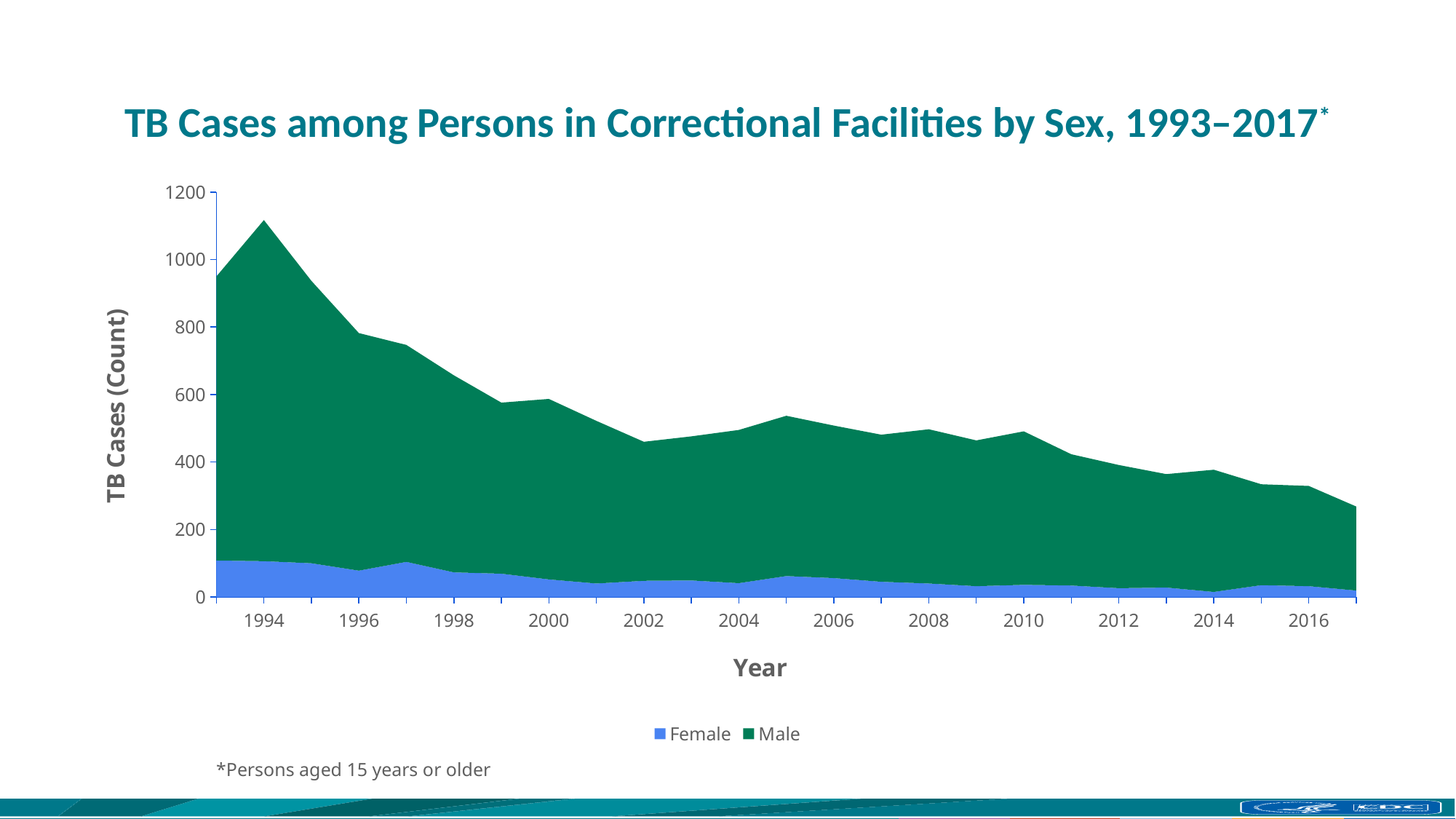
Overall, do total TB cases rise or fall from 1993 to 2017? Fall Which series are listed in the legend? Female and Male What kind of chart is shown on the slide? Stacked area chart Is the total number of TB cases in 2017 greater or less than 400? less In 2000, which series has more TB cases, Male or Female? Male How many series does the legend list? 2 Is the number of Female TB cases in 2014 greater or less than 100? less In which year is the total number of TB cases lowest? 2017 In which year is the total number of TB cases highest? 1994 Is the total number of TB cases in 1994 greater or less than 1000? greater What colour represents the Male series? Green